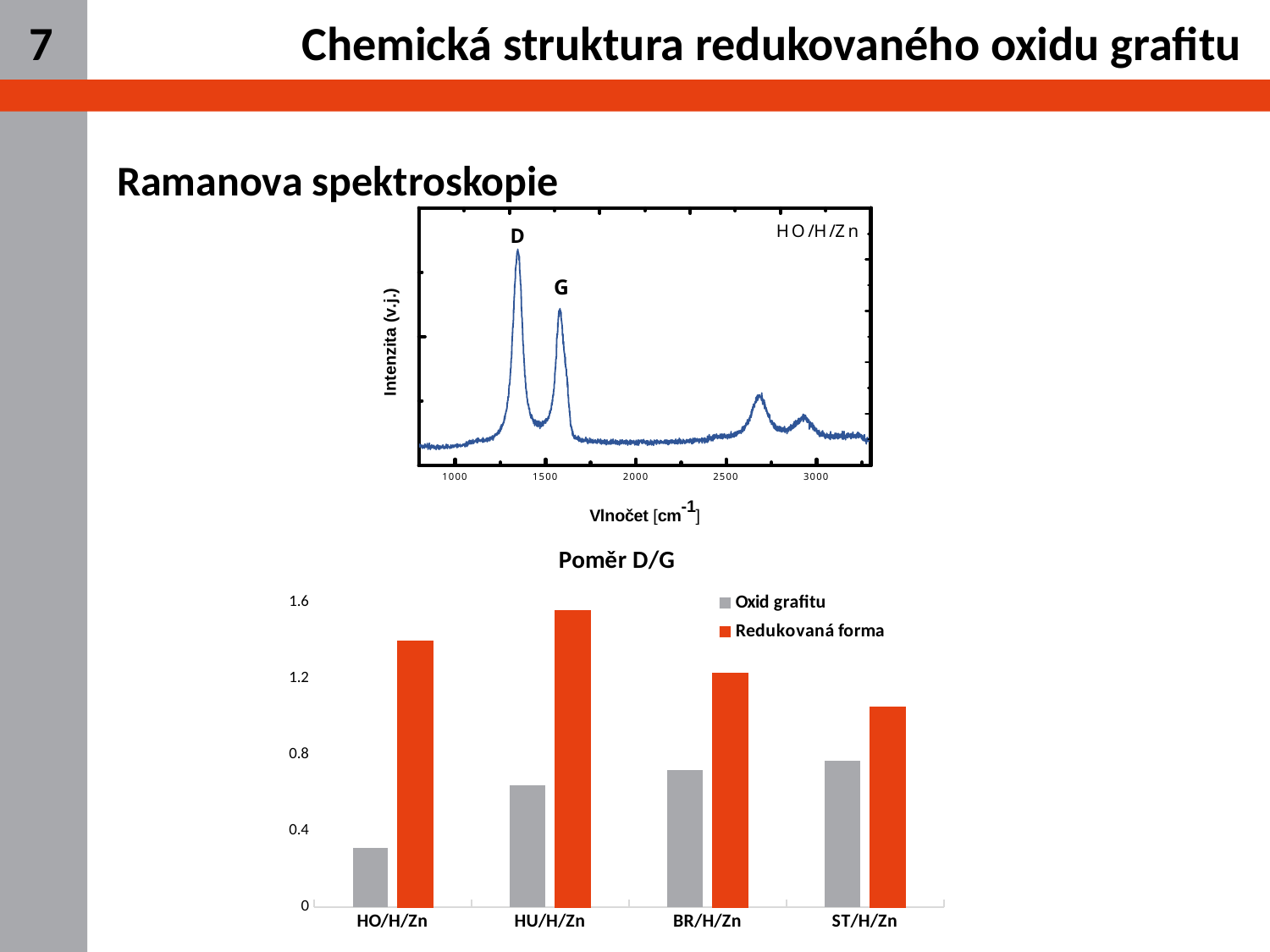
In the 'Poměr D/G' chart, how many series does the legend list? 2 In the 'Poměr D/G' chart, how many categories are shown on the x axis? 4 In the 'Poměr D/G' chart, which category has the lowest value for Oxid grafitu? HO/H/Zn In the 'Poměr D/G' chart, is the Redukovaná forma value for HO/H/Zn greater or less than 1.2? greater In the Raman spectrum chart at the top, what are the two labelled peaks called? D and G In the 'Poměr D/G' chart, which category has the lowest value for Redukovaná forma? ST/H/Zn In the 'Poměr D/G' chart, is the Oxid grafitu value for HO/H/Zn greater or less than 0.4? less In the 'Poměr D/G' chart, is the Redukovaná forma value for ST/H/Zn greater or less than 1.2? less In the 'Poměr D/G' chart, which category has the highest value for Redukovaná forma? HU/H/Zn In the 'Poměr D/G' chart, for BR/H/Zn, which series has the larger value: Oxid grafitu or Redukovaná forma? Redukovaná forma In the 'Poměr D/G' chart, which series is shown in orange? Redukovaná forma In the 'Poměr D/G' chart, what kind of chart is it? bar chart